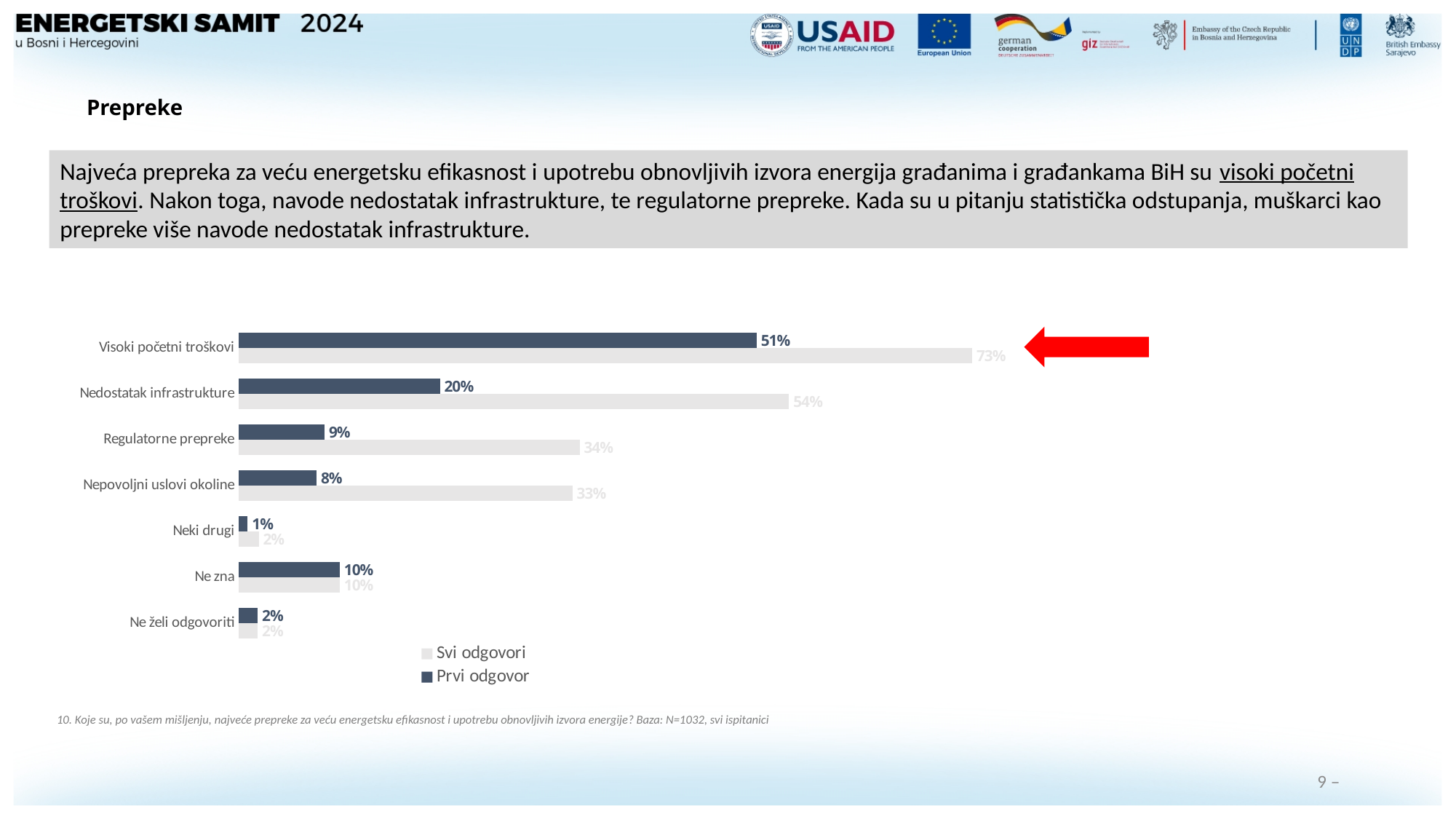
What is the difference between the 'Svi odgovori' and 'Prvi odgovor' values for Visoki početni troškovi? 22% Which series is shown in dark blue in the legend? Prvi odgovor What is the 'Svi odgovori' value for Regulatorne prepreke? 34% Which is larger: the 'Svi odgovori' value for Nedostatak infrastrukture or for Regulatorne prepreke? Nedostatak infrastrukture What kind of chart is shown on the slide? Bar chart What is the 'Prvi odgovor' value for Nedostatak infrastrukture? 20% What is the 'Svi odgovori' value for Visoki početni troškovi? 73% What is the 'Prvi odgovor' value for Nepovoljni uslovi okoline? 8% How many series does the legend list? 2 Which category has the highest 'Svi odgovori' value? Visoki početni troškovi Which category has the lowest 'Prvi odgovor' value? Neki drugi How many categories are shown in the chart? 7